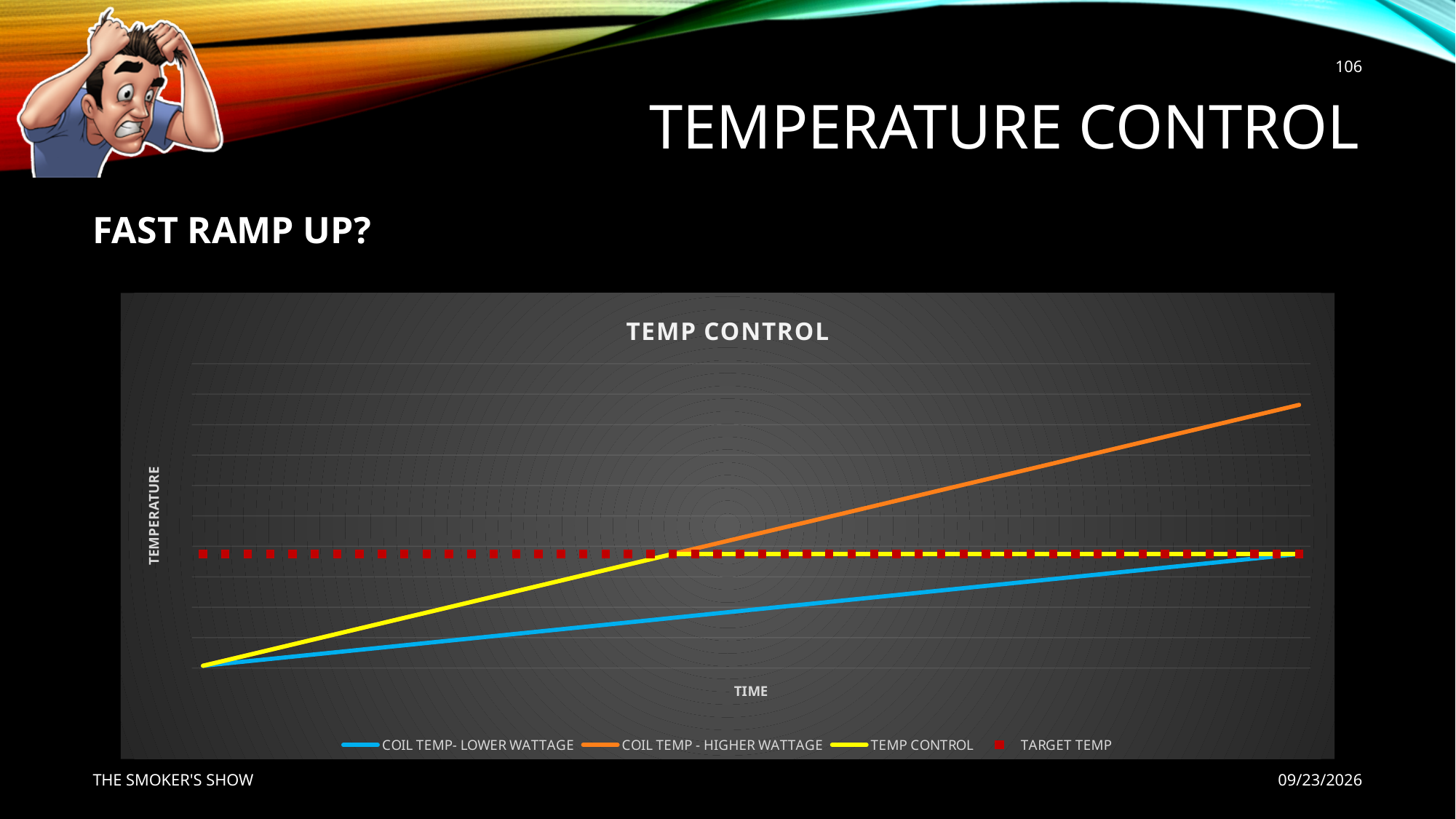
What is the label on the vertical axis of the chart? TEMPERATURE Does the COIL TEMP - HIGHER WATTAGE line rise or fall along the time axis? Rise What is the title of the chart? TEMP CONTROL How many series does the chart legend list? 4 Does the TEMP CONTROL line rise throughout the chart, or does it rise and then level off? Rise and then level off Does the COIL TEMP- LOWER WATTAGE line rise or fall along the time axis? Rise Which series reaches the highest temperature at the right end of the chart? COIL TEMP - HIGHER WATTAGE What kind of chart is shown on the slide? Line chart At the right end of the chart, which is higher: COIL TEMP - HIGHER WATTAGE or COIL TEMP- LOWER WATTAGE? COIL TEMP - HIGHER WATTAGE